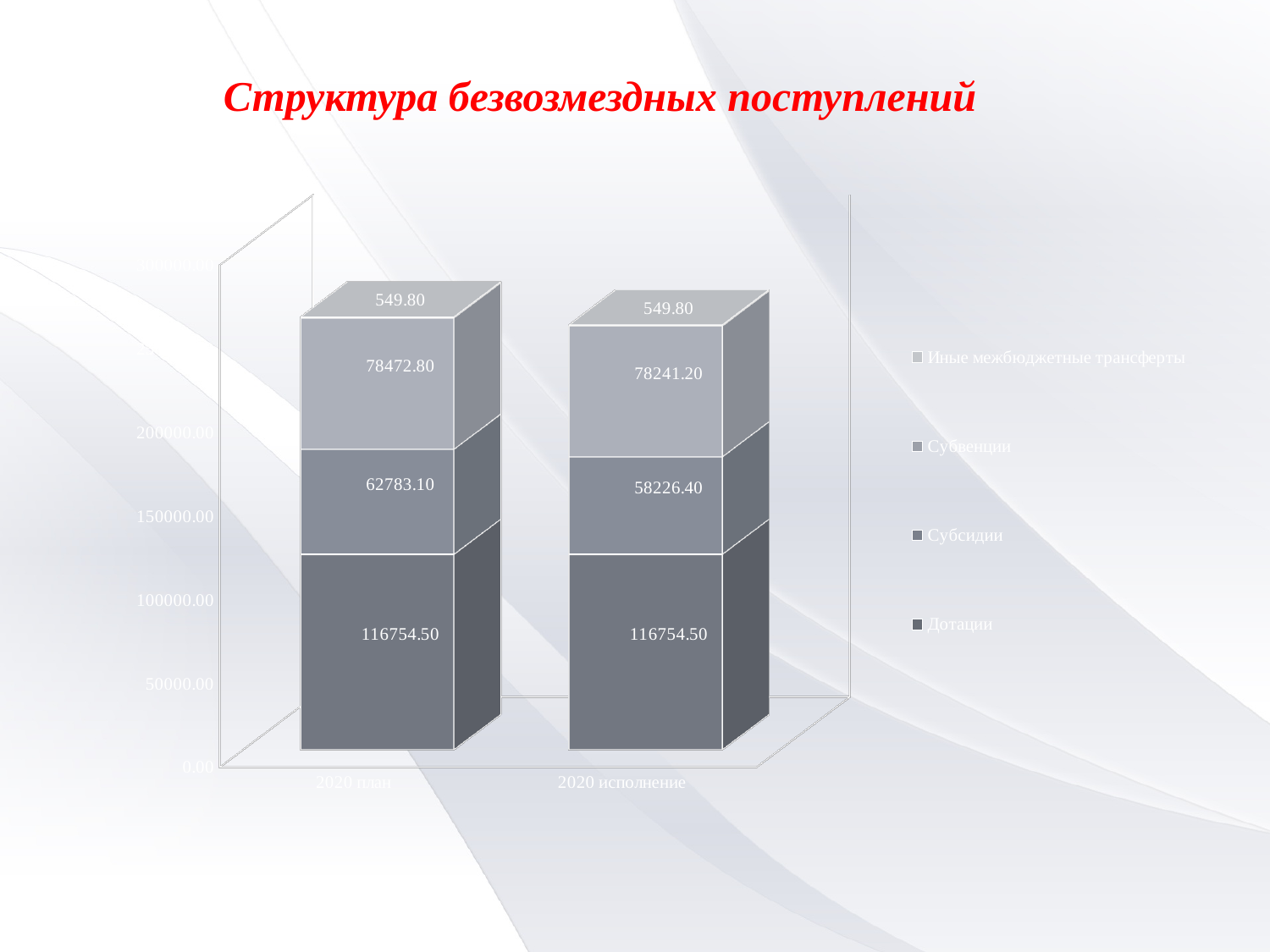
How many categories are shown on the x axis? 2 What is the total of the 2020 план stacked bar? 258560.20 What is the value of Субвенции for 2020 план? 78472.80 What is the value of Иные межбюджетные трансферты for 2020 исполнение? 549.80 Which series has the largest value in the 2020 исполнение bar? Дотации What is the difference between the Субсидии values for 2020 план and 2020 исполнение? 4556.70 What is the title of the chart? Структура безвозмездных поступлений What is the value of Субсидии for 2020 исполнение? 58226.40 What is the value of Дотации for 2020 план? 116754.50 Which series has the smallest value in the 2020 план bar? Иные межбюджетные трансферты What kind of chart is shown on the slide? Stacked bar chart How many series does the legend list? 4